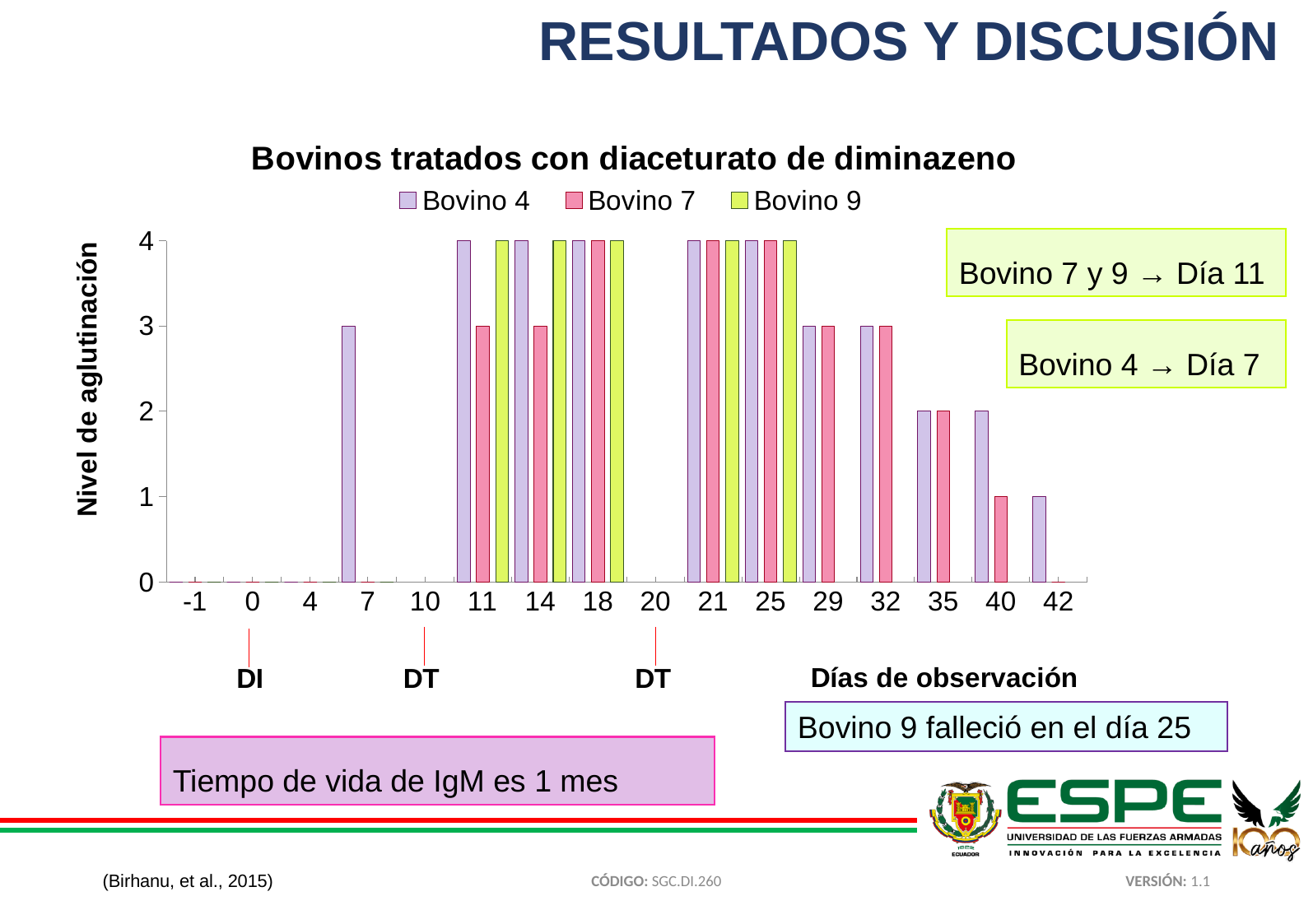
Do the values for Bovino 4 rise or fall from day 25 to day 42? fall What is the title of the chart? Bovinos tratados con diaceturato de diminazeno How many series does the legend of the chart list? 3 What is the agglutination level for Bovino 7 on day 11? 3 On day 40, which is larger, the value for Bovino 4 or the value for Bovino 7? Bovino 4 What is the agglutination level for Bovino 9 on day 18? 4 What is the label of the y axis of the chart? Nivel de aglutinación How many observation days are labelled on the x axis of the chart? 16 What is the difference between the values for Bovino 4 and Bovino 7 on day 14? 1 What is the agglutination level for Bovino 7 on day 40? 1 What is the agglutination level for Bovino 4 on day 7? 3 What kind of chart is shown on the slide? bar chart